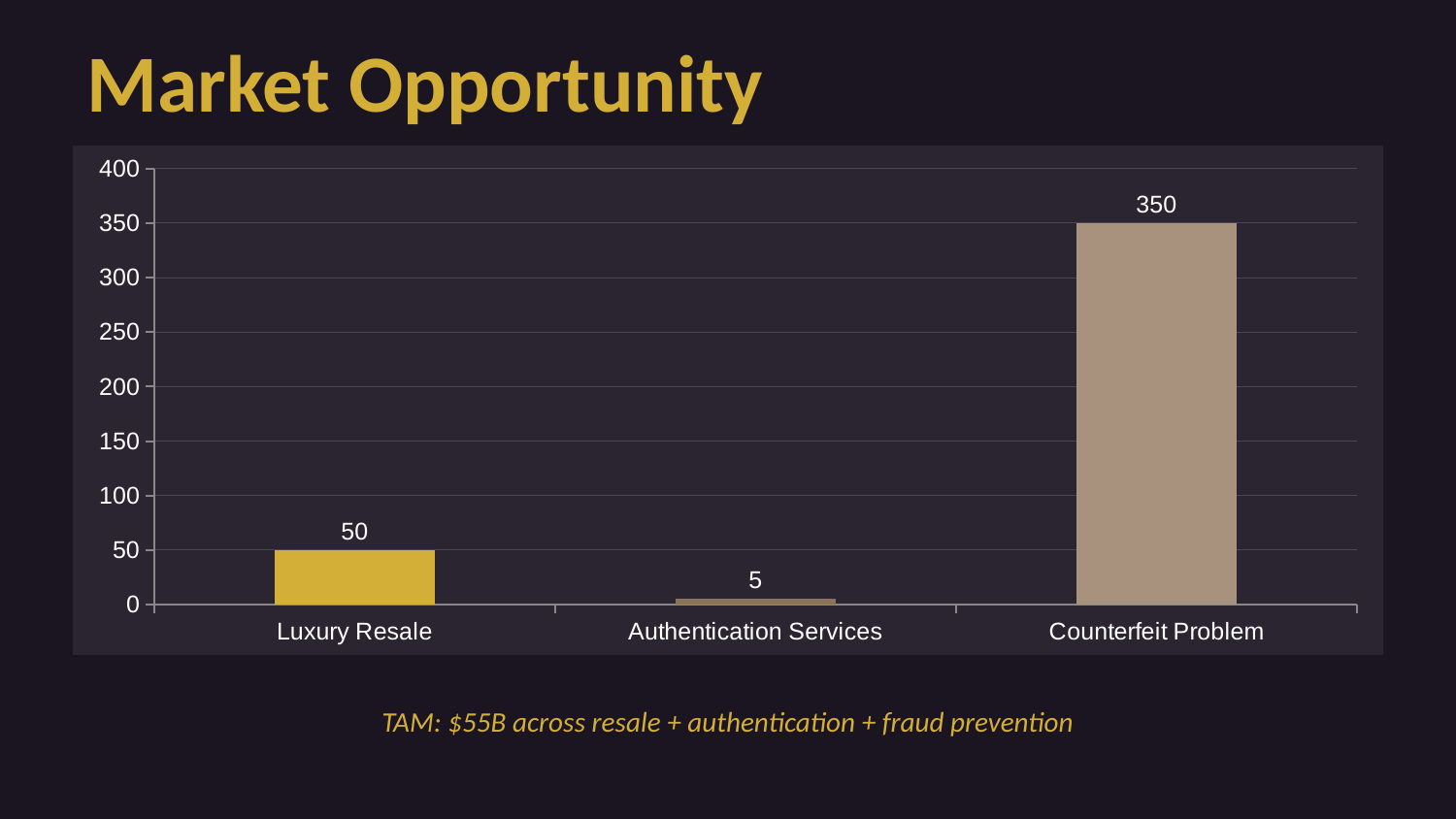
What is the value for Authentication Services? 5 Which category has the lowest value? Authentication Services What is the difference between the values for Counterfeit Problem and Luxury Resale? 300 What kind of chart is shown on the slide? Bar chart Is the value for Counterfeit Problem greater or less than 300? greater Which is larger, the value for Luxury Resale or the value for Authentication Services? Luxury Resale How many categories are shown on the chart? 3 What is the value for Luxury Resale? 50 What is the title of the slide containing the chart? Market Opportunity Which category has the highest value? Counterfeit Problem What is the value for Counterfeit Problem? 350 What is the difference between the values for Luxury Resale and Authentication Services? 45